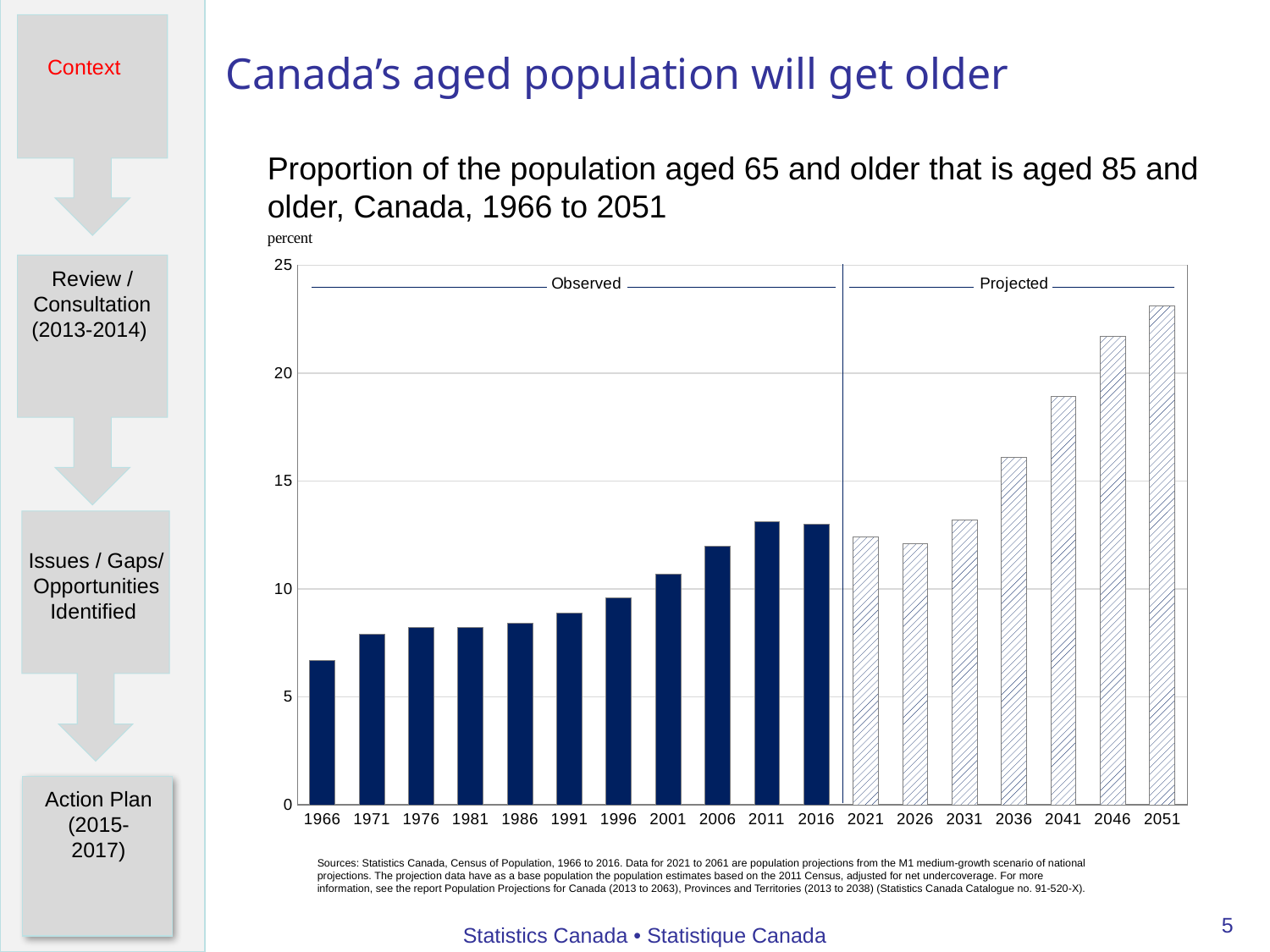
What kind of chart is shown on the slide? bar chart Overall, do the values rise or fall from 1966 to 2051? rise Is the value for 1966 greater or less than 5? greater Is the value for 2051 greater or less than 20? greater What are the two labelled sections of the chart, separated by the vertical line? Observed and Projected Which is larger, the value for 2036 or the value for 2016? 2036 How many years (bars) are plotted on the chart? 18 Which year has the lowest proportion of the population aged 65 and older that is aged 85 and older? 1966 Is the value for 1996 greater or less than 10? less Which year has the highest proportion of the population aged 65 and older that is aged 85 and older? 2051